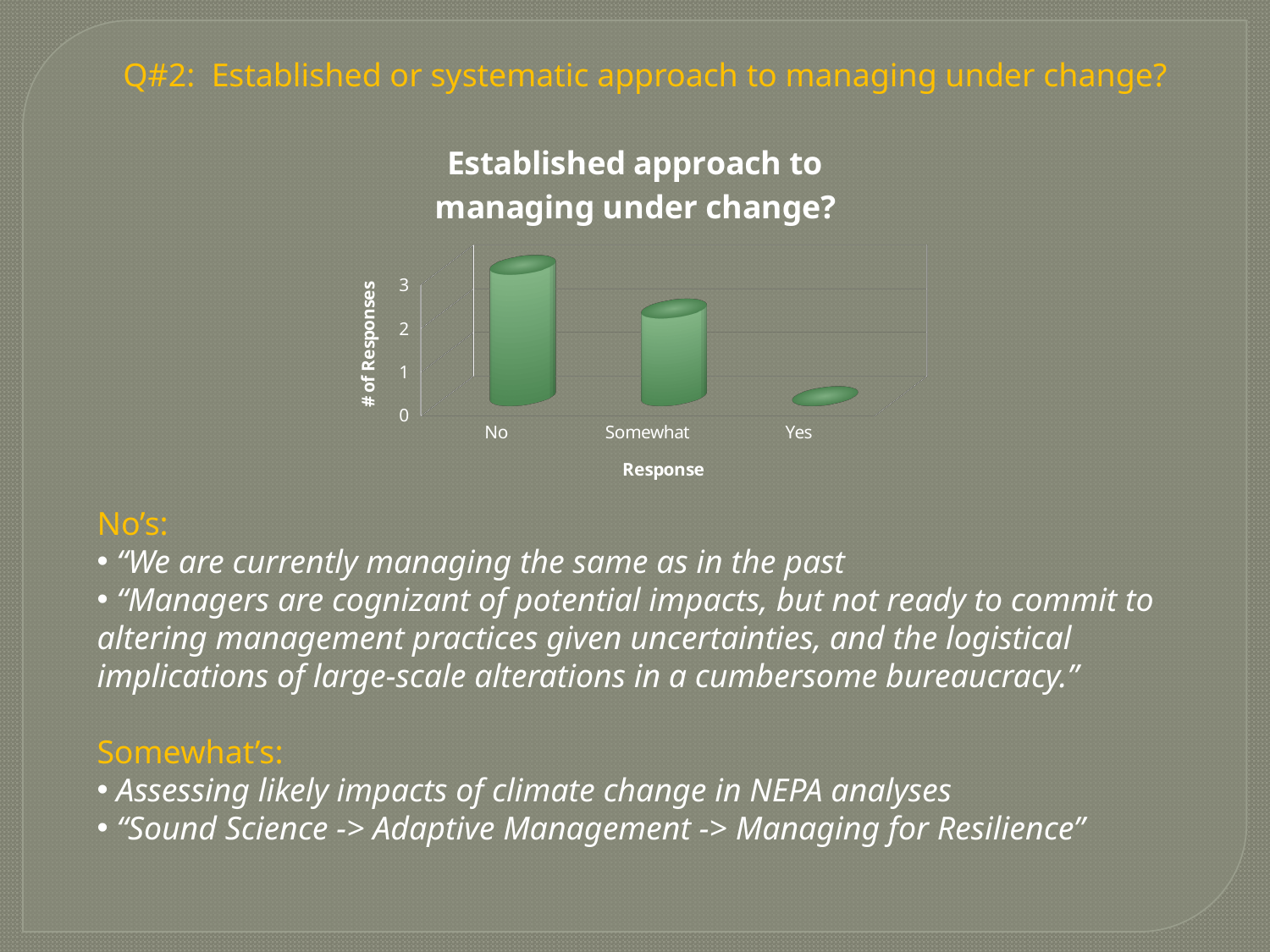
Which has more responses, "No" or "Somewhat"? No Is the number of responses for "No" greater or less than 2? greater What is the title of the chart? Established approach to managing under change? Is the number of responses for "Yes" greater or less than 1? less Which response category has the highest number of responses? No How many response categories are shown on the x axis of the chart? 3 What is the label of the vertical axis of the chart? # of Responses Which response category has the lowest number of responses? Yes Do the values rise or fall moving from "No" to "Yes" along the x axis? fall What kind of chart is shown on the slide? bar chart Which has more responses, "Somewhat" or "Yes"? Somewhat Is the number of responses for "Somewhat" greater or less than 1? greater